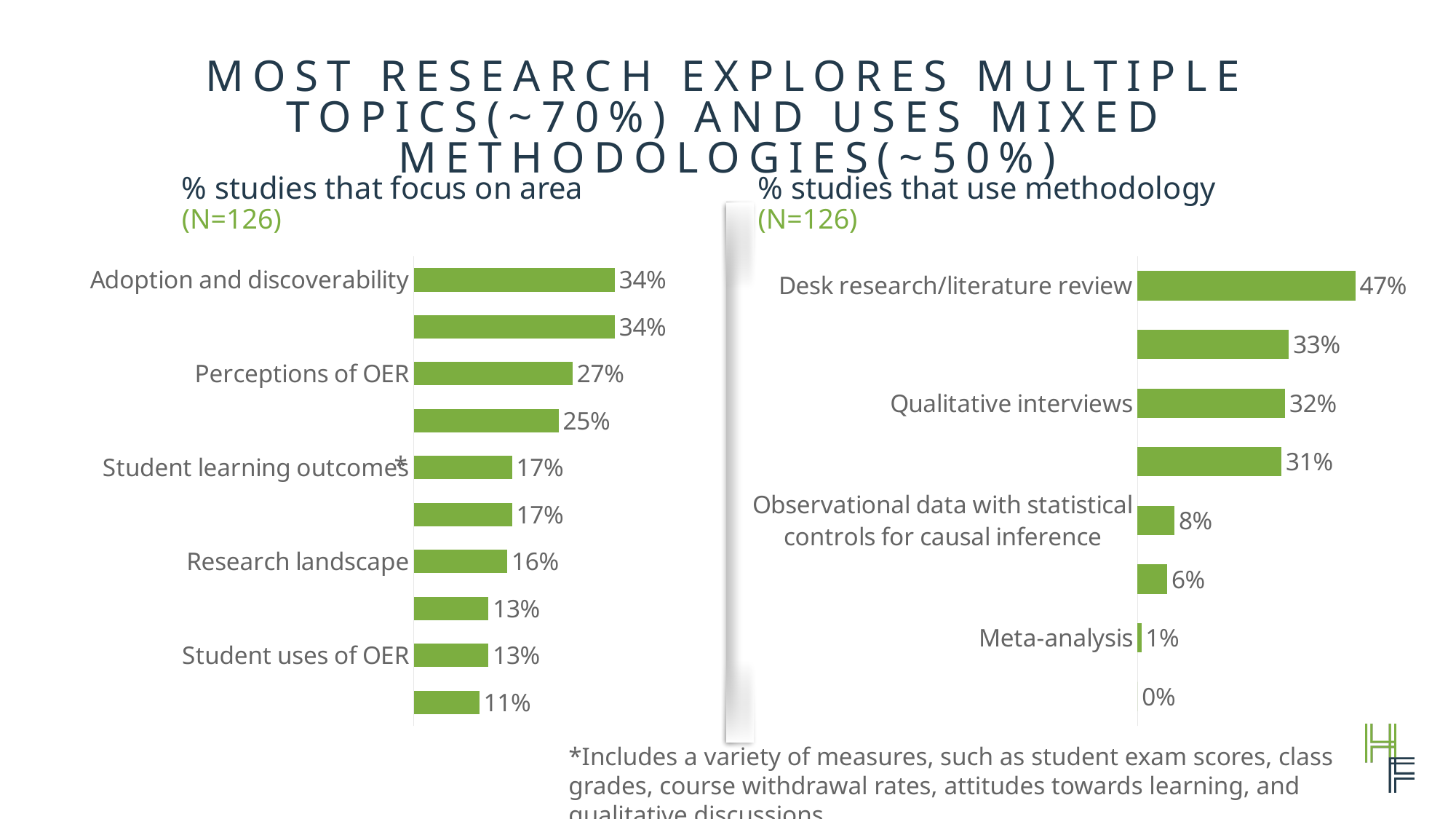
In the chart titled '% studies that use methodology', which methodology has the highest percentage? Desk research/literature review In the chart titled '% studies that focus on area', what is the value for Perceptions of OER? 27% In the chart titled '% studies that use methodology', what is the value for Meta-analysis? 1% In the chart titled '% studies that focus on area', what percentage of studies focus on Adoption and discoverability? 34% What type of chart is the chart titled '% studies that use methodology'? Bar chart In the chart titled '% studies that use methodology', which is larger: Qualitative interviews or Observational data with statistical controls for causal inference? Qualitative interviews How many bars are plotted in the chart titled '% studies that focus on area'? 10 In the chart titled '% studies that focus on area', what is the value for Research landscape? 16% In the chart titled '% studies that focus on area', what is the difference between Adoption and discoverability and Student uses of OER? 21% In the chart titled '% studies that focus on area', what is the value of the smallest bar? 11% In the chart titled '% studies that use methodology', what percentage of studies use Desk research/literature review? 47% In the chart titled '% studies that use methodology', what is the value for Qualitative interviews? 32%